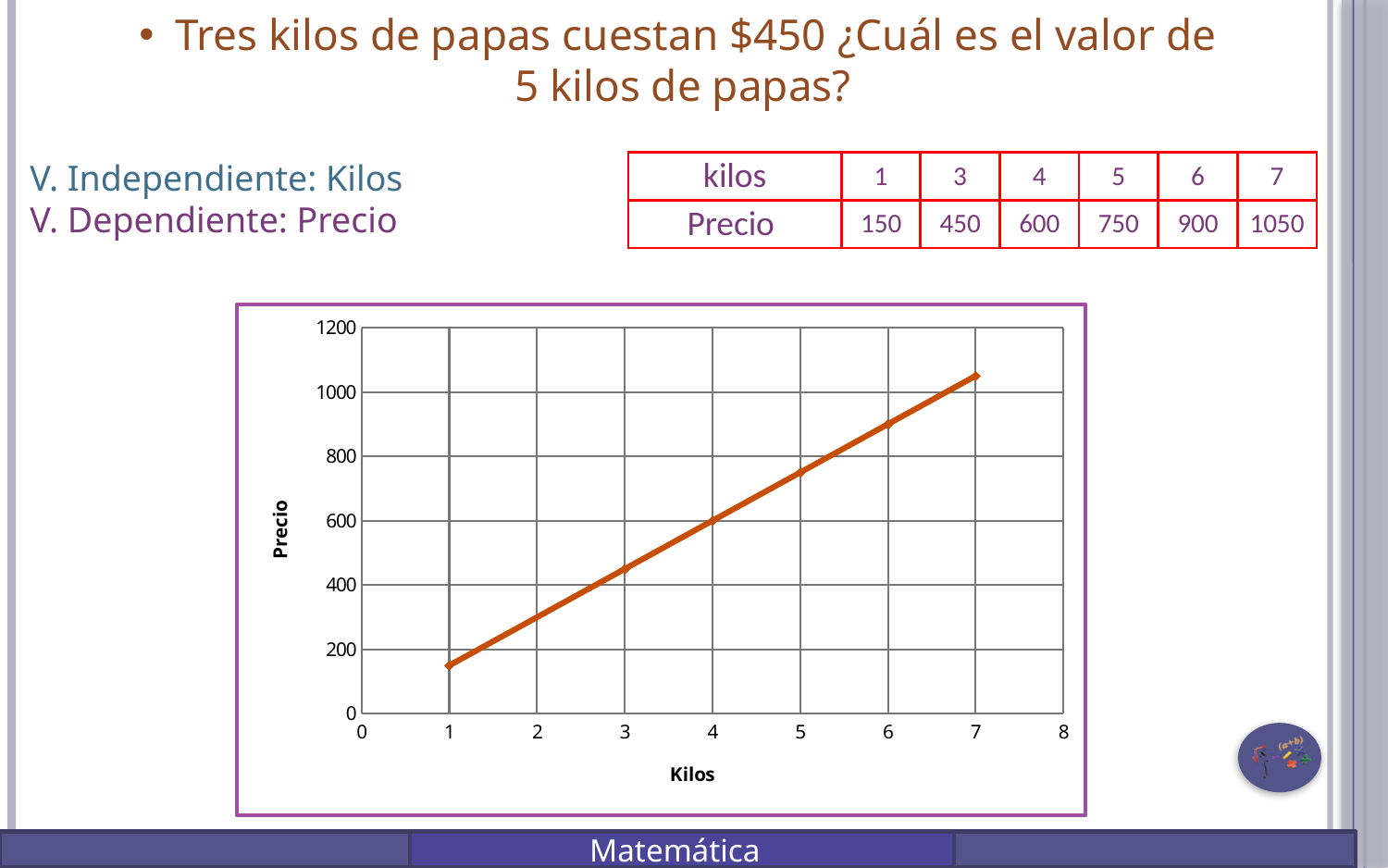
Is the Precio for 6 kilos greater or less than 800? greater What is the difference in Precio between 7 kilos and 3 kilos? 600 What kind of chart is shown on the slide? line chart What is the label of the horizontal axis of the chart? Kilos What is the Precio for 5 kilos? 750 Which has a larger Precio, 3 kilos or 5 kilos? 5 kilos At which number of kilos is the Precio highest? 7 At which number of kilos is the Precio lowest? 1 Does the Precio rise or fall as Kilos increases along the x axis? rise What is the Precio for 7 kilos? 1050 What is the Precio for 4 kilos? 600 What is the label of the vertical axis of the chart? Precio